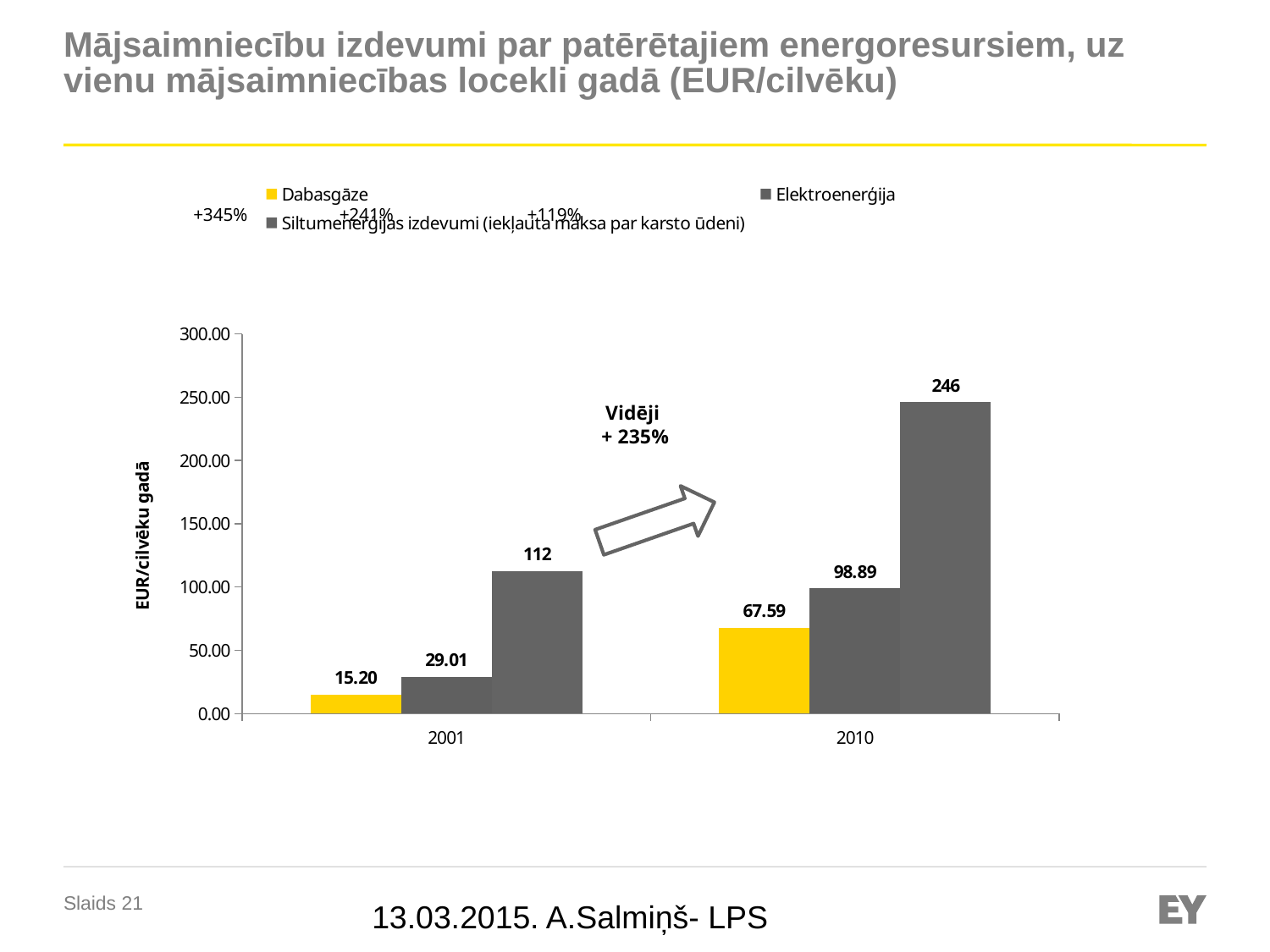
What is the value for Dabasgāze in 2001? 15.20 What is the highest value shown in the chart? 246 How many series does the legend list? 3 How many year categories are shown on the x axis? 2 What is the value for Dabasgāze in 2010? 67.59 What is the title of the y axis? EUR/cilvēku gadā By how much did the value for Dabasgāze increase from 2001 to 2010? 52.39 What is the difference between the tallest bar in 2010 and the tallest bar in 2001? 134 What is the value of the tallest bar in the 2001 group? 112 What is the lowest value shown in the chart? 15.20 What kind of chart is shown on the slide? bar chart Which year has the larger value for Dabasgāze, 2001 or 2010? 2010